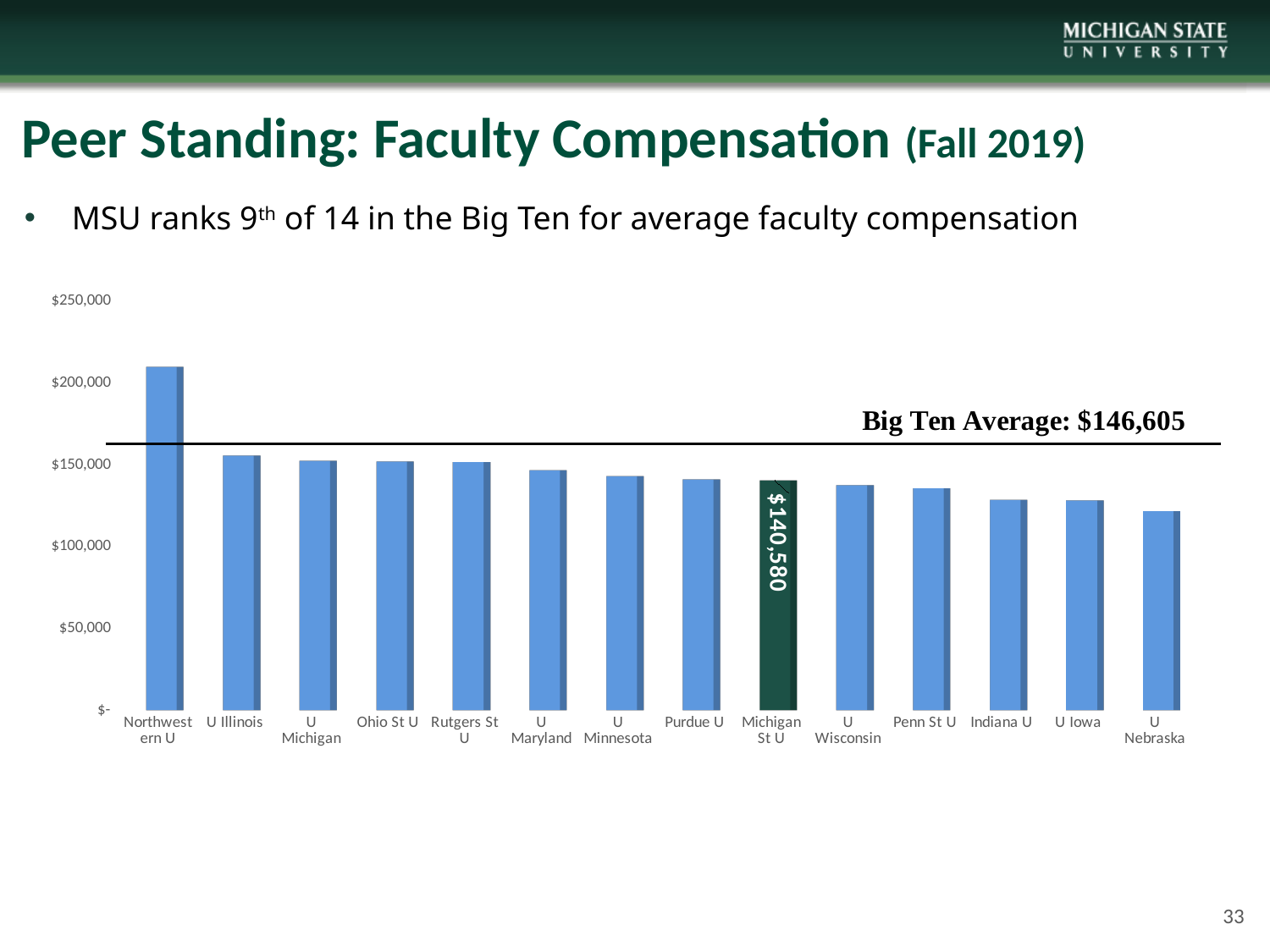
How many universities are shown as bars in the chart? 14 What Big Ten Average value is printed on the chart? $146,605 What kind of chart is shown on the slide? bar chart Which is larger, the value for Northwestern U or the value for U Illinois? Northwestern U Is the value for Northwestern U greater or less than $200,000? greater Which university has the highest average faculty compensation in the chart? Northwestern U Is the value for U Nebraska greater or less than $150,000? less What is the average faculty compensation value labeled for Michigan St U? $140,580 Do the bar values rise or fall moving from left to right across the chart? fall Which university's bar is highlighted in dark green rather than blue? Michigan St U What is the difference between the Big Ten Average ($146,605) and the Michigan St U value ($140,580)? $6,025 Which university has the lowest average faculty compensation in the chart? U Nebraska